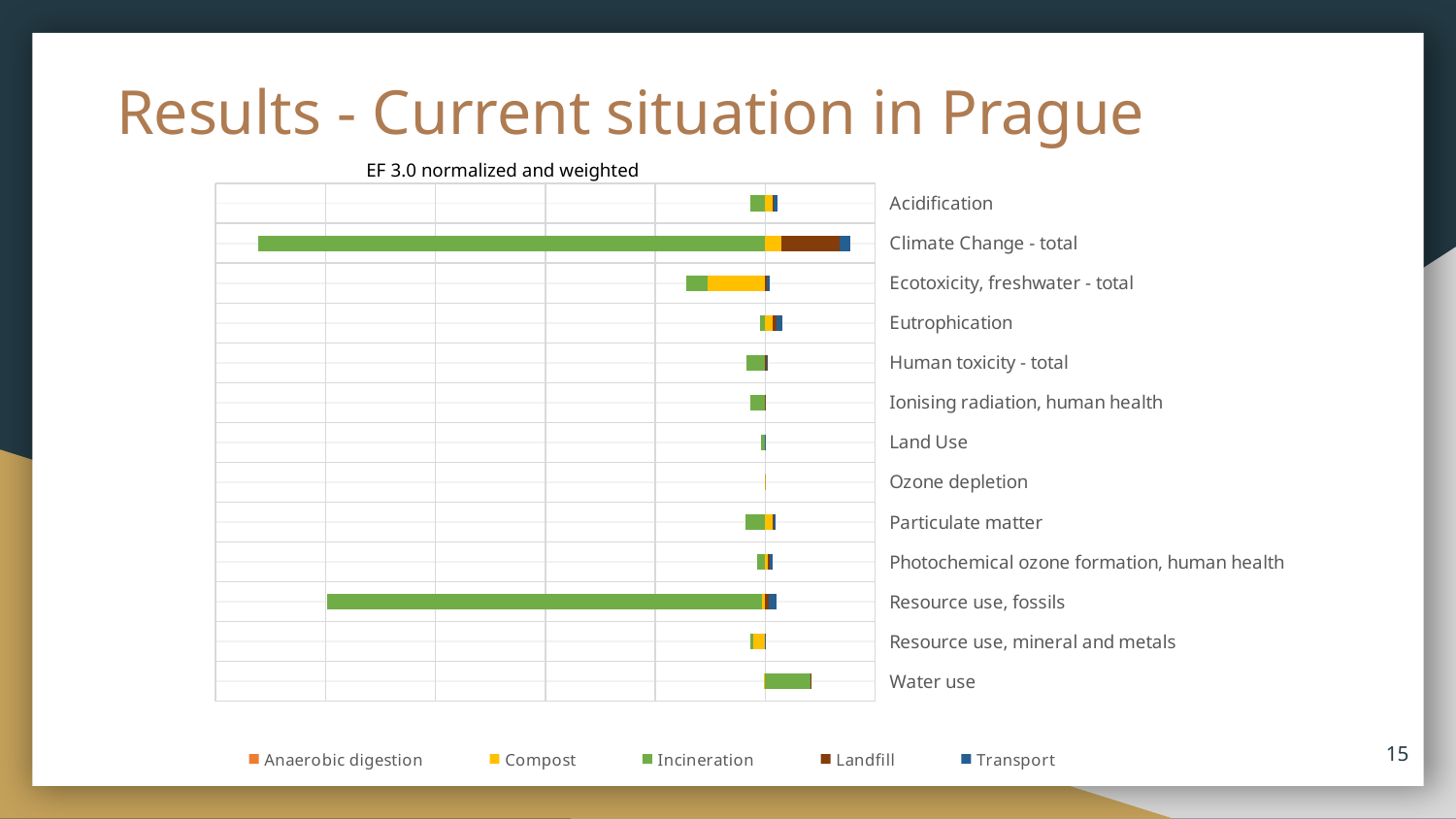
Which series is shown in green in the legend? Incineration How many impact categories are listed on the chart? 13 Which impact category has the shortest bar on the chart? Ozone depletion Which bar is longer, Ecotoxicity, freshwater - total or Human toxicity - total? Ecotoxicity, freshwater - total What kind of chart is shown on the slide? Bar chart Which impact category has the longest bar on the chart? Climate Change - total Which series makes up the largest part of the Climate Change - total bar? Incineration What is the title of the chart? EF 3.0 normalized and weighted Which impact category shows the largest Landfill segment? Climate Change - total How many series does the legend list? 5 Which bar is longer, Climate Change - total or Resource use, fossils? Climate Change - total